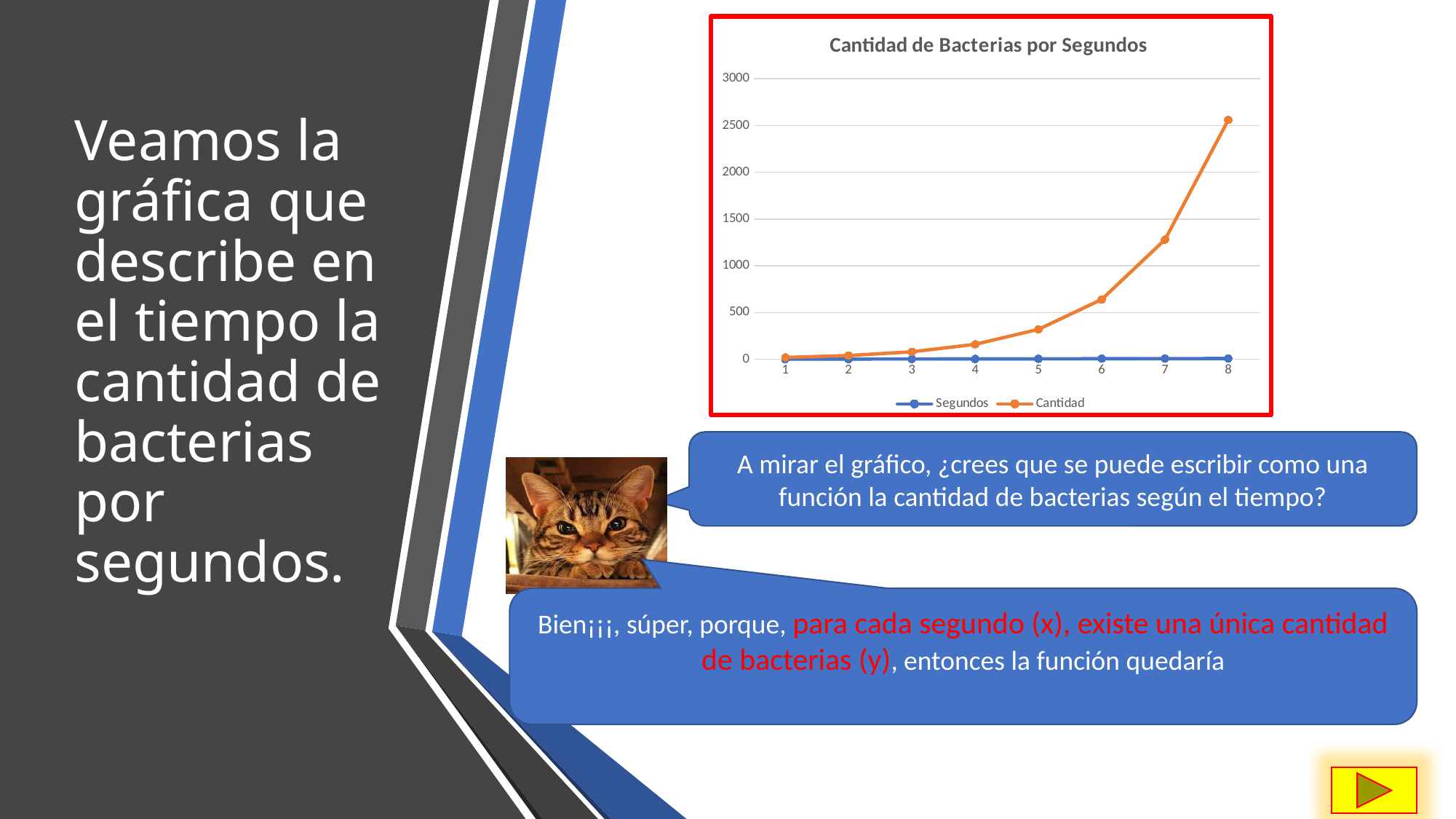
At x = 8, which series has the larger value, Segundos or Cantidad? Cantidad What is the title of the chart? Cantidad de Bacterias por Segundos Is the Cantidad value at x = 5 greater or less than 500? less How many series does the legend list? 2 At which x value does the Cantidad series reach its highest point? 8 Is the Cantidad value at x = 7 greater or less than 1500? less Which colour is used for the Cantidad series? orange At which x value is the Cantidad series lowest? 1 How many points are plotted along the x axis for each series? 8 What kind of chart is shown on the slide? line chart Is the Cantidad value at x = 8 greater or less than 2000? greater Does the Cantidad series rise or fall as x increases from 1 to 8? rise